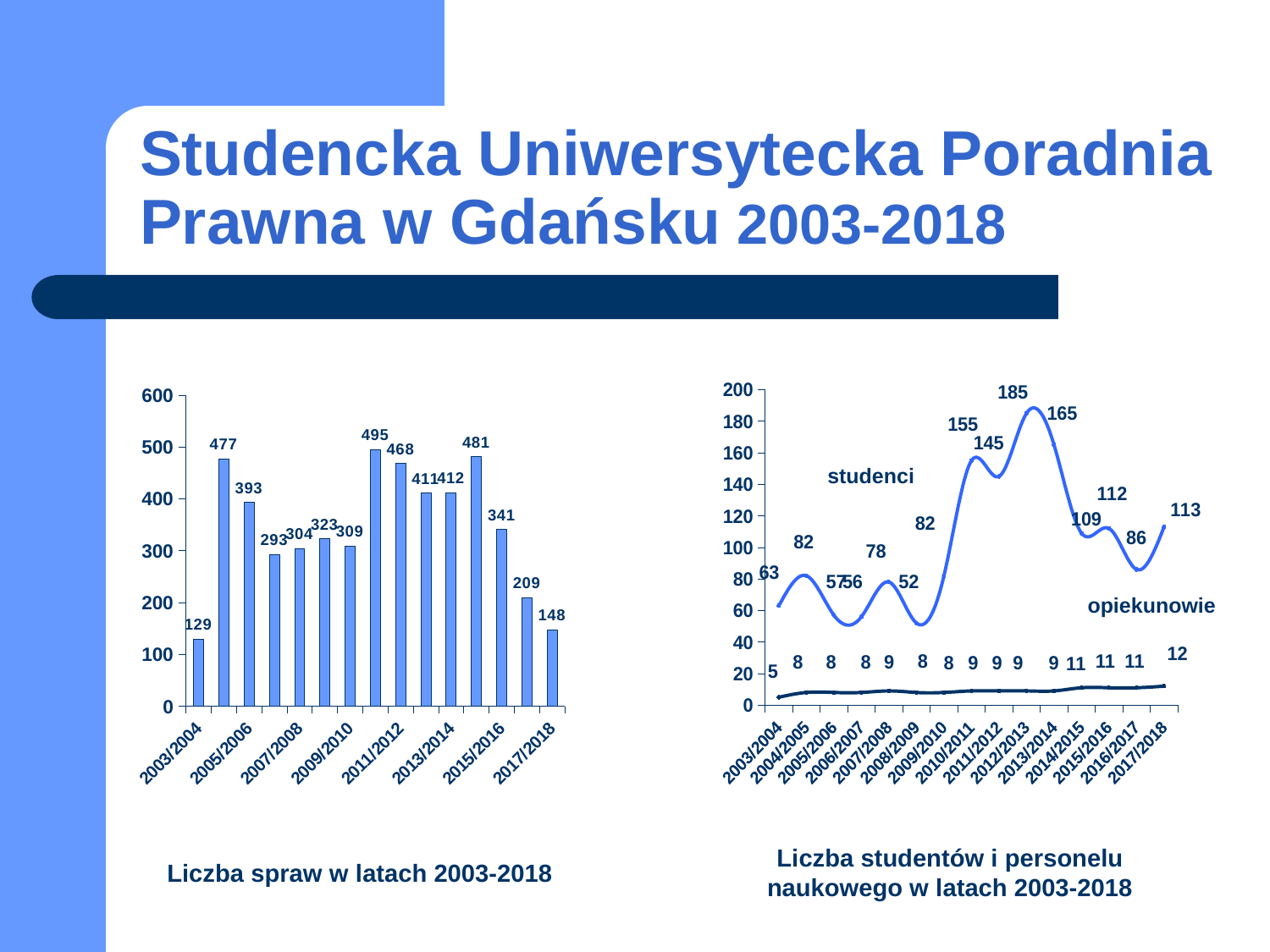
In the chart 'Liczba spraw w latach 2003-2018', what is the value for 2017/2018? 148 In the chart 'Liczba spraw w latach 2003-2018', what is the difference between the values for 2011/2012 and 2015/2016? 127 In the chart 'Liczba spraw w latach 2003-2018', which year has the lowest value? 2003/2004 In the chart 'Liczba studentów i personelu naukowego w latach 2003-2018', what is the value for studenci in 2012/2013? 185 How many series are plotted in the chart 'Liczba studentów i personelu naukowego w latach 2003-2018'? 2 In the chart 'Liczba spraw w latach 2003-2018', what is the highest value shown? 495 In the chart 'Liczba spraw w latach 2003-2018', what is the value for 2003/2004? 129 In the chart 'Liczba studentów i personelu naukowego w latach 2003-2018', what is the value for opiekunowie in 2017/2018? 12 In the chart 'Liczba studentów i personelu naukowego w latach 2003-2018', what is the difference between studenci and opiekunowie in 2017/2018? 101 What kind of chart is 'Liczba spraw w latach 2003-2018'? bar chart How many bars are in the chart 'Liczba spraw w latach 2003-2018'? 15 In the chart 'Liczba spraw w latach 2003-2018', which is larger: the value for 2005/2006 or 2013/2014? 2013/2014